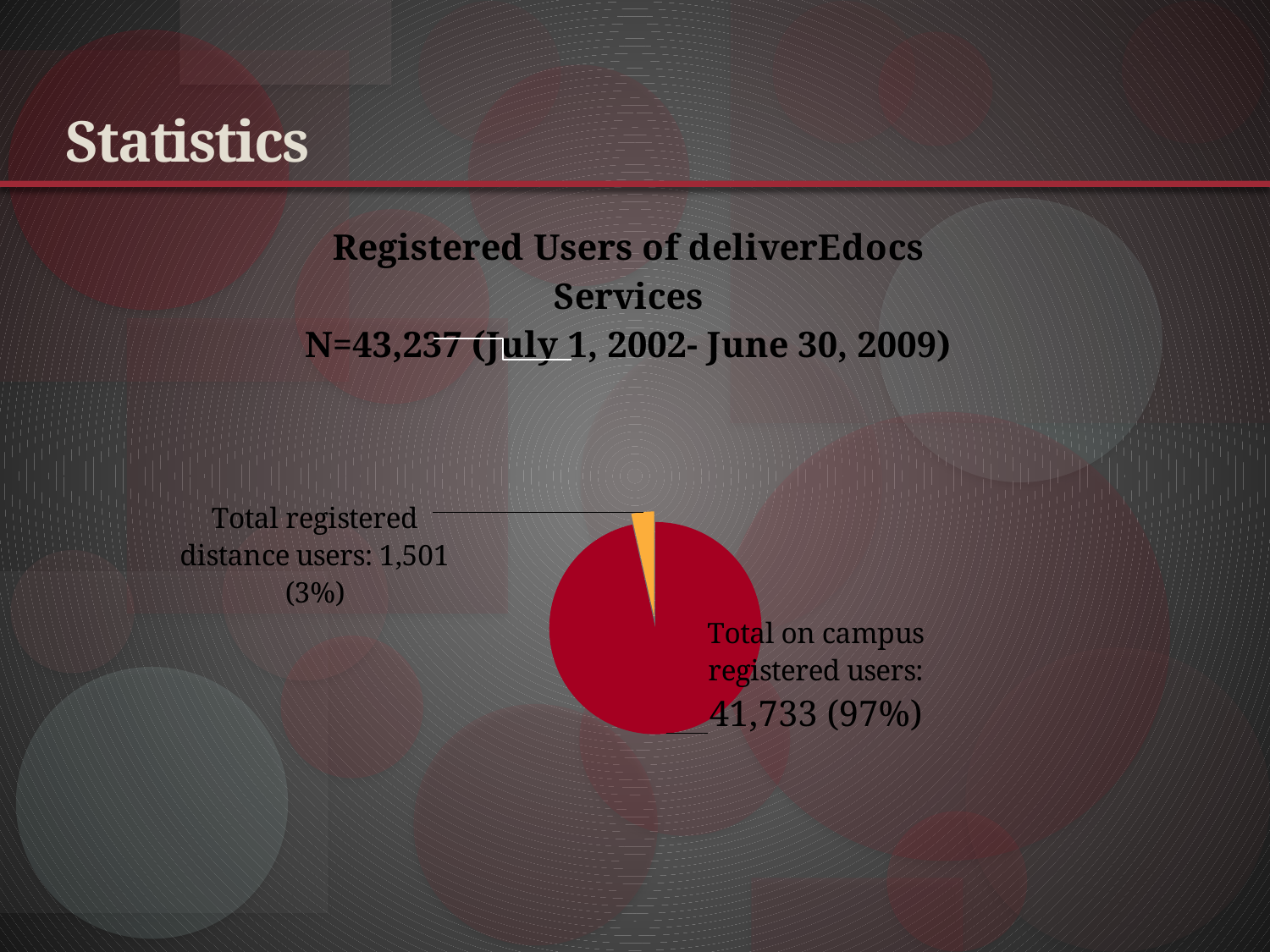
What is the number of total on campus registered users? 41,733 Which slice is the largest in the pie chart? Total on campus registered users Which is larger: the number of on campus registered users or distance users? on campus registered users What kind of chart is shown on the slide? pie chart What is the difference between the number of on campus registered users and distance users? 40,232 What share of the pie do total on campus registered users represent? 97% What share of the pie do total registered distance users represent? 3% What colour is the slice for total registered distance users? orange What is the number of total registered distance users? 1,501 How many slices does the pie chart have? 2 What is the total N stated in the chart title? 43,237 Which slice is the smallest in the pie chart? Total registered distance users